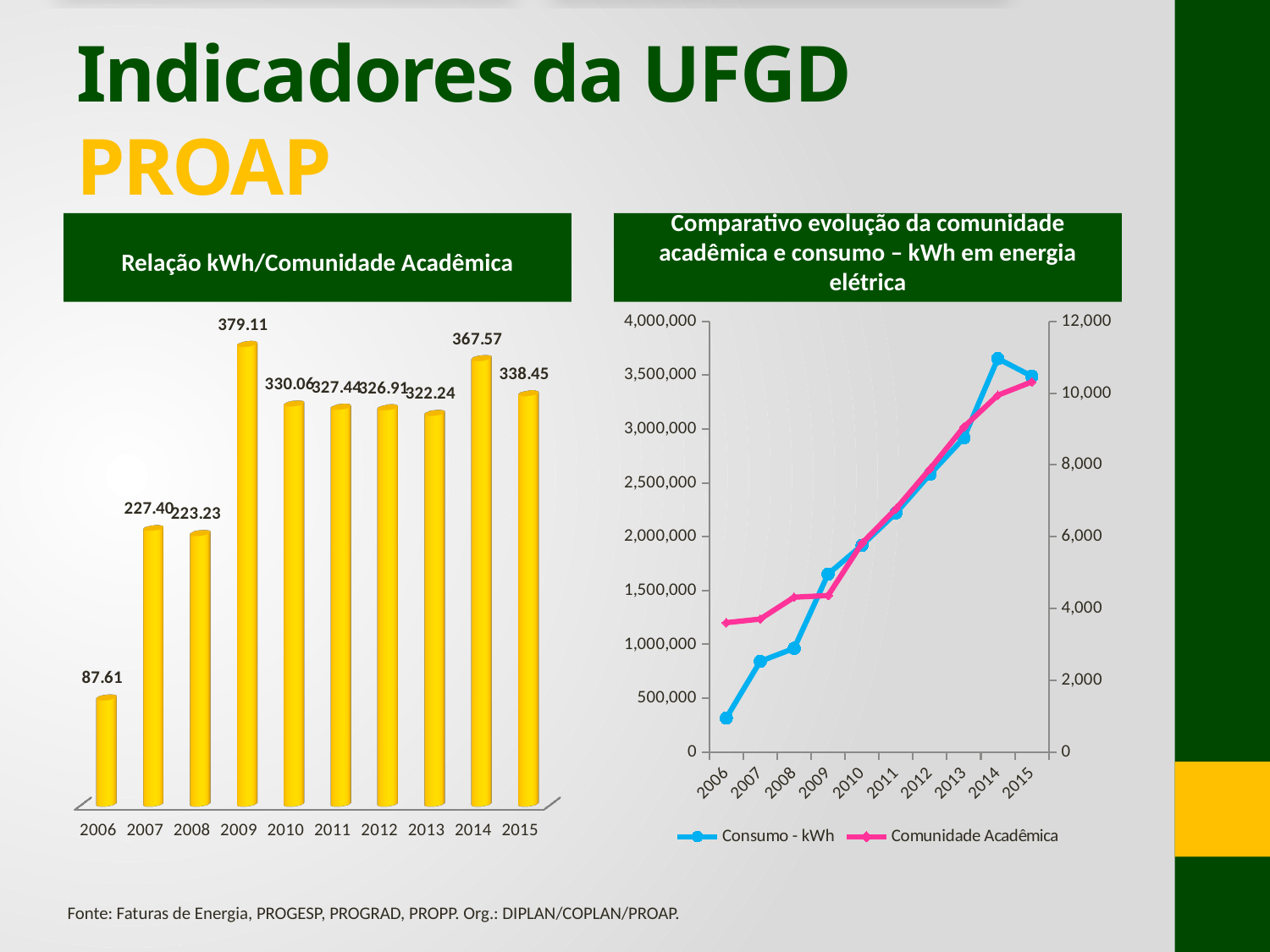
In the 'Relação kWh/Comunidade Acadêmica' chart, what is the value for 2006? 87.61 How many series does the legend of the 'Comparativo evolução da comunidade acadêmica e consumo' chart list? 2 What kind of chart is the 'Relação kWh/Comunidade Acadêmica' chart? Bar chart In the 'Comparativo evolução da comunidade acadêmica e consumo' chart, does the Consumo - kWh series rise or fall from 2006 to 2014? Rise In the 'Relação kWh/Comunidade Acadêmica' chart, what is the value for 2009? 379.11 What kind of chart is the 'Comparativo evolução da comunidade acadêmica e consumo' chart? Line chart In the 'Relação kWh/Comunidade Acadêmica' chart, which year has the lowest value? 2006 How many years are shown in the 'Relação kWh/Comunidade Acadêmica' chart? 10 In the 'Relação kWh/Comunidade Acadêmica' chart, which year has the highest value? 2009 In the 'Relação kWh/Comunidade Acadêmica' chart, what is the difference between the values for 2014 and 2015? 29.12 In the 'Relação kWh/Comunidade Acadêmica' chart, which year has the larger value, 2007 or 2008? 2007 In the 'Comparativo evolução da comunidade acadêmica e consumo' chart, is the Consumo - kWh value for 2006 greater or less than 500,000? less